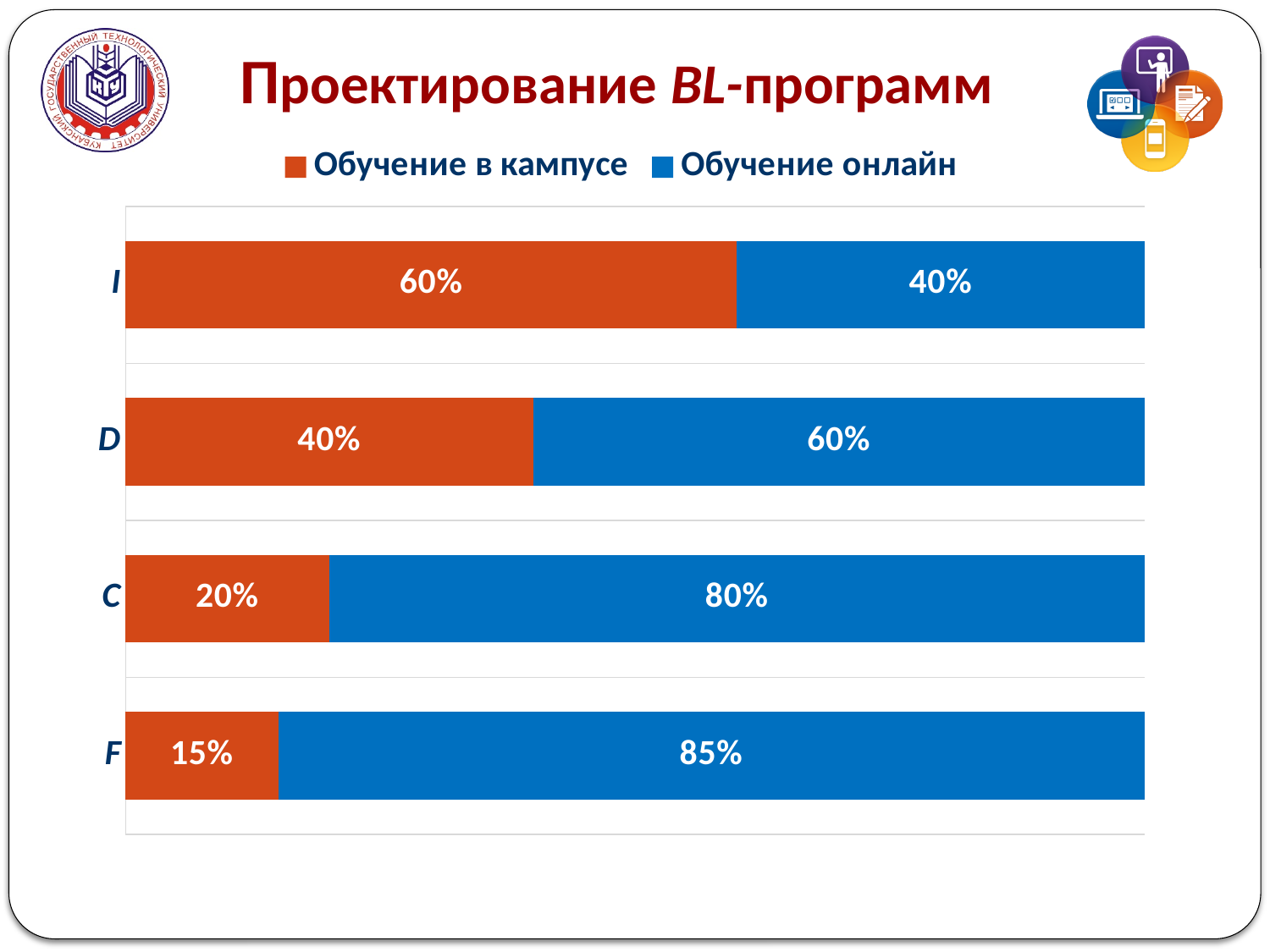
What is the value for "Обучение онлайн" for category F? 85% What is the value for "Обучение в кампусе" for category C? 20% What is the value for "Обучение в кампусе" for category I? 60% What is the total of the stacked bar for category C? 100% What is the value for "Обучение онлайн" for category D? 60% How many categories are shown on the chart? 4 Which category has the highest value for "Обучение в кампусе"? I How many series does the legend list? 2 Which category has the lowest value for "Обучение онлайн"? I What is the difference between the "Обучение онлайн" values for F and C? 5% Which is larger: "Обучение в кампусе" for D or "Обучение в кампусе" for F? D What kind of chart is shown on the slide? Stacked bar chart